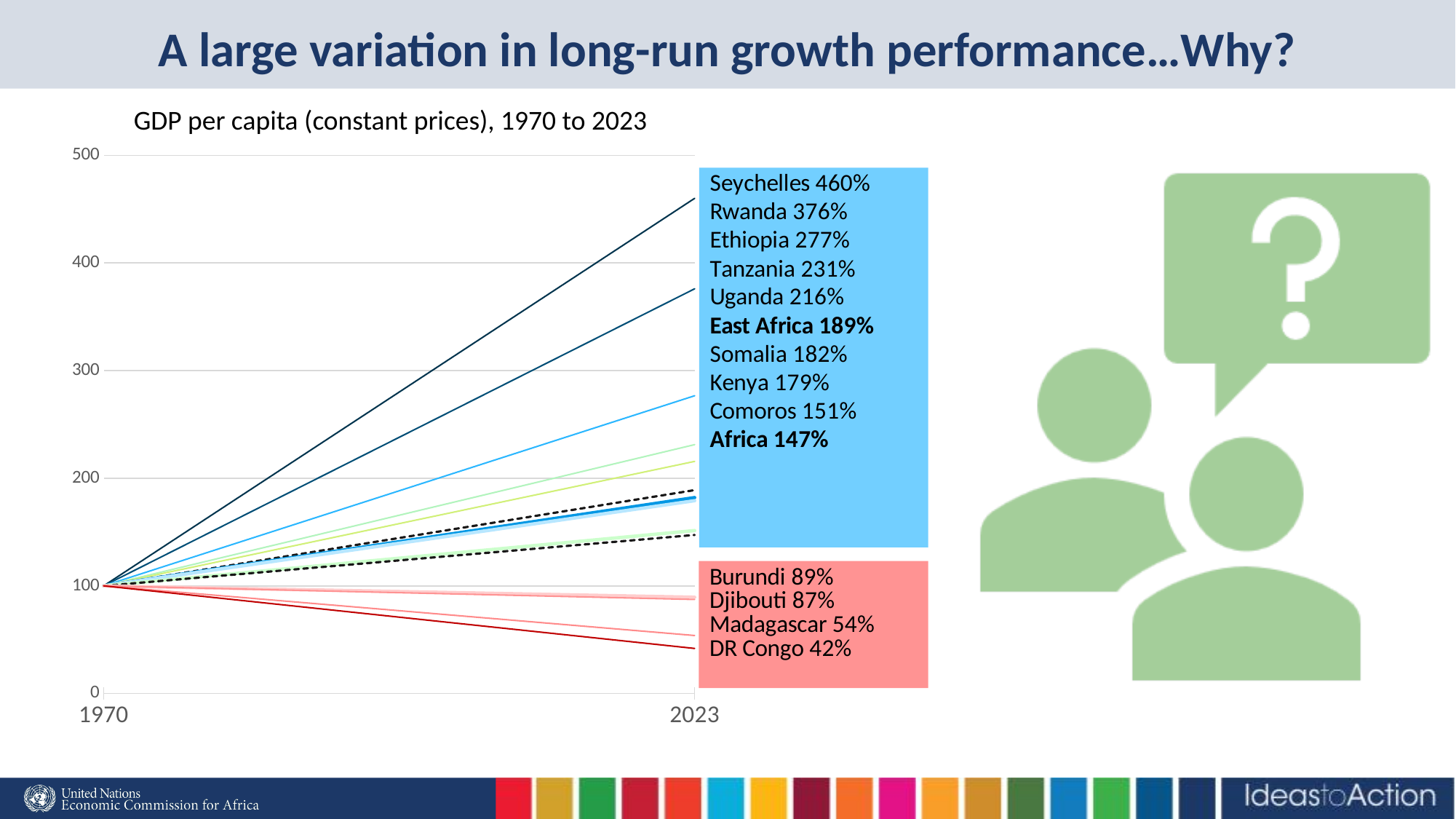
What kind of chart is used to show GDP per capita from 1970 to 2023? line chart What is the 2023 value shown for DR Congo in the GDP per capita chart? 42% What is the 2023 value shown for East Africa in the GDP per capita chart? 189% Is the 2023 value for Burundi greater or less than 100? less Which has the larger 2023 value, Somalia or Kenya? Somalia Does the line for Madagascar rise or fall from 1970 to 2023? fall Which country has the highest 2023 value in the GDP per capita chart? Seychelles Which country has the lowest 2023 value in the GDP per capita chart? DR Congo What is the 2023 value shown for Seychelles in the GDP per capita chart? 460% What is the 2023 value shown for Africa in the GDP per capita chart? 147% How many countries or regions are labelled with a 2023 value on the chart? 14 What is the difference between the 2023 values for Seychelles and Rwanda? 84 percentage points